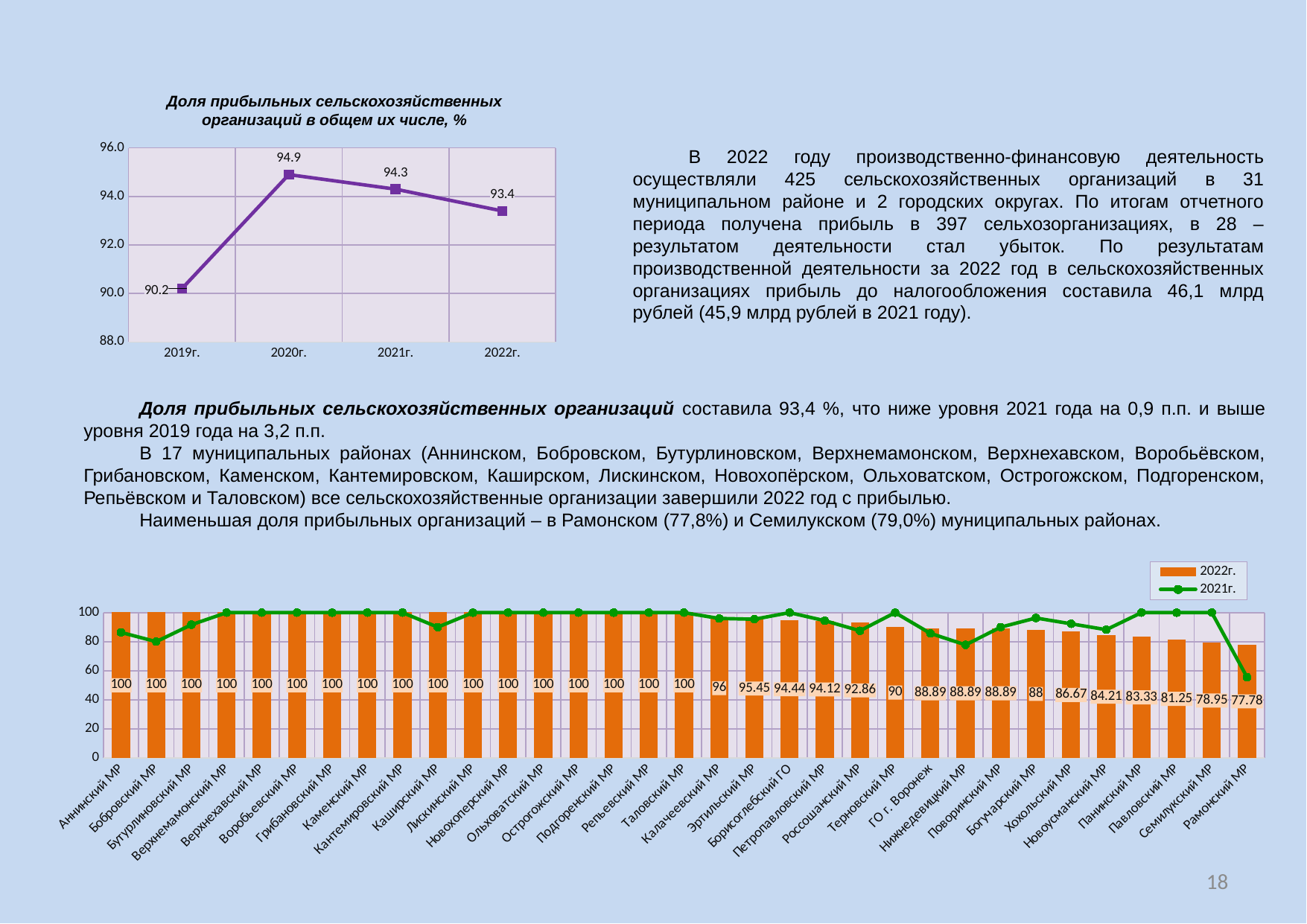
How many series does the legend of the bottom chart list? 2 In the top-left chart, do the values rise or fall from 2020г. to 2022г.? fall In the bottom chart, which has the larger 2022г. value: Терновский МР or Богучарский МР? Терновский МР In the top-left chart 'Доля прибыльных сельскохозяйственных организаций в общем их числе, %', what is the value for 2020г.? 94.9 In the top-left chart, which year has the lowest value? 2019г. In the top-left chart, which year has the highest value? 2020г. In the bottom chart, what is the 2022г. value for Рамонский МР? 77.78 In the bottom chart, which category has the lowest 2022г. value? Рамонский МР What kind of chart is the top-left chart? line chart In the bottom chart, what is the 2022г. value for Калачеевский МР? 96 In the top-left chart, what is the difference between the values for 2020г. and 2022г.? 1.5 In the bottom chart, is the 2021г. value for Рамонский МР greater or less than 60? less